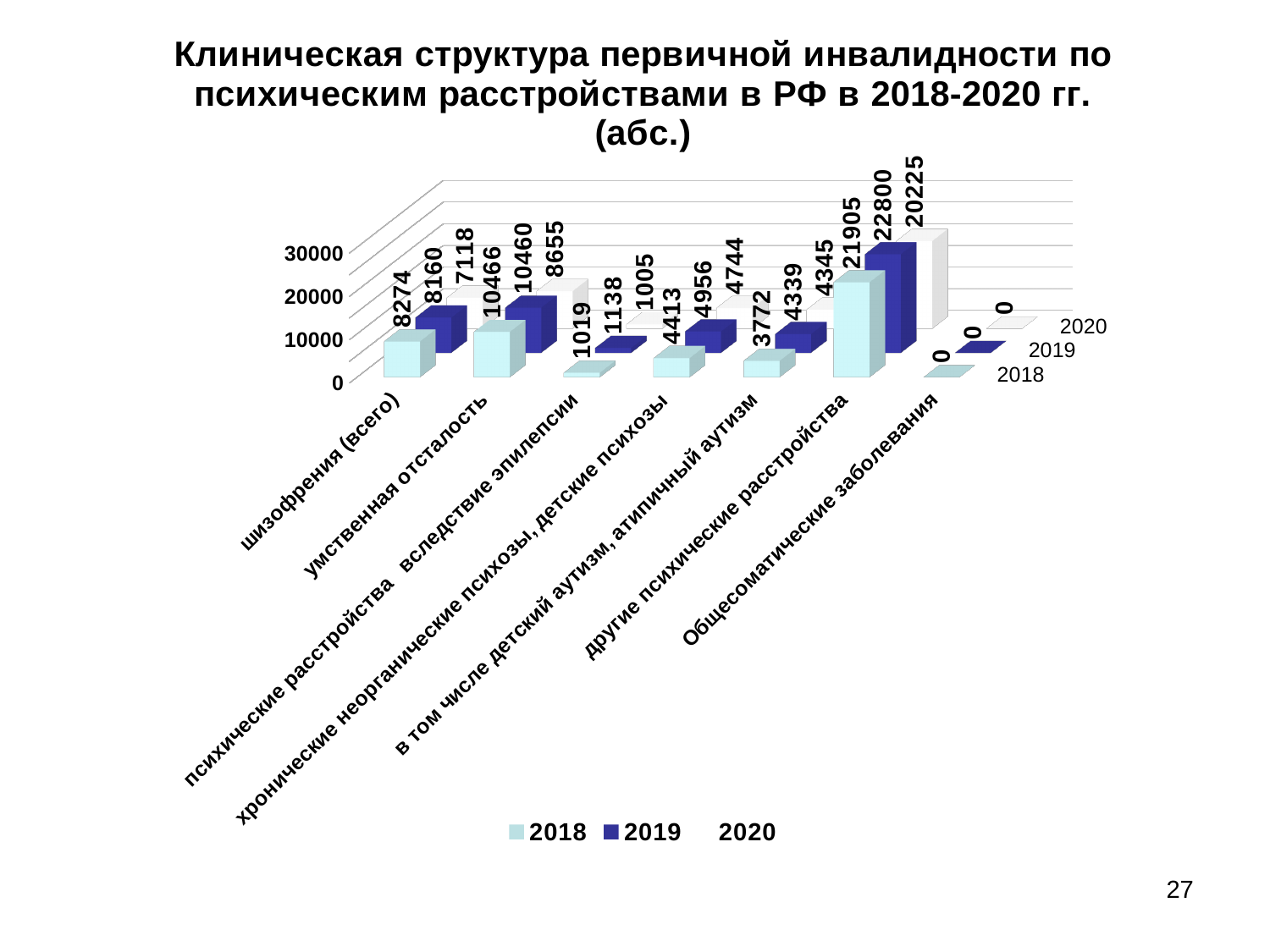
What is the 2020 value for умственная отсталость? 8655 What is the 2018 value for шизофрения (всего)? 8274 Do the values for шизофрения (всего) rise or fall from 2018 to 2020? fall What is the difference between the 2019 and 2020 values for другие психические расстройства? 2575 What kind of chart is shown on the slide? bar chart What is the 2020 value for психические расстройства вследствие эпилепсии? 1005 How many series does the legend list? 3 What is the 2019 value for другие психические расстройства? 22800 Which category has the lowest value in 2018? Общесоматические заболевания How many categories are shown on the x axis? 7 Which category has the highest value in 2019? другие психические расстройства Which is larger: the 2018 value for хронические неорганические психозы, детские психозы or the 2018 value for в том числе детский аутизм, атипичный аутизм? хронические неорганические психозы, детские психозы